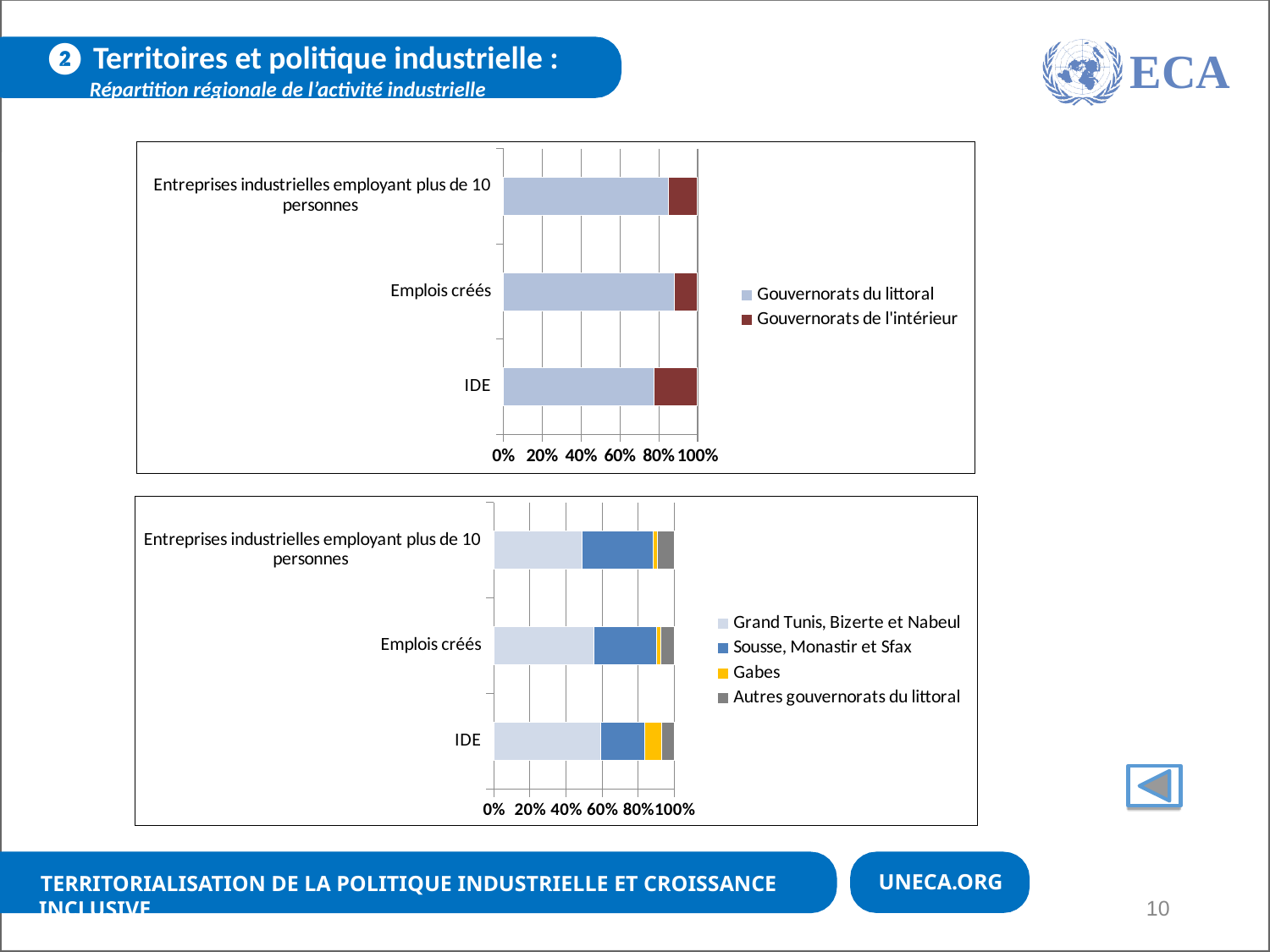
In the top chart, is the value for Gouvernorats de l'intérieur for IDE greater or less than 40%? less What kind of chart is the top chart on the slide? Stacked bar chart In the bottom chart, is the value for Grand Tunis, Bizerte et Nabeul for IDE greater or less than 40%? greater How many categories are shown on the top chart? 3 How many categories are shown on the bottom chart? 3 In the top chart, is the value for Gouvernorats du littoral for IDE greater or less than 60%? greater In the top chart, which category has the largest Gouvernorats de l'intérieur segment? IDE In the bottom chart, what colour represents Gabes in the legend? Yellow In the bottom chart, is the Gabes segment larger for IDE or for Emplois créés? IDE How many series does the legend of the bottom chart list? 4 How many series does the legend of the top chart list? 2 In the top chart, is the Gouvernorats de l'intérieur segment larger for IDE or for Emplois créés? IDE